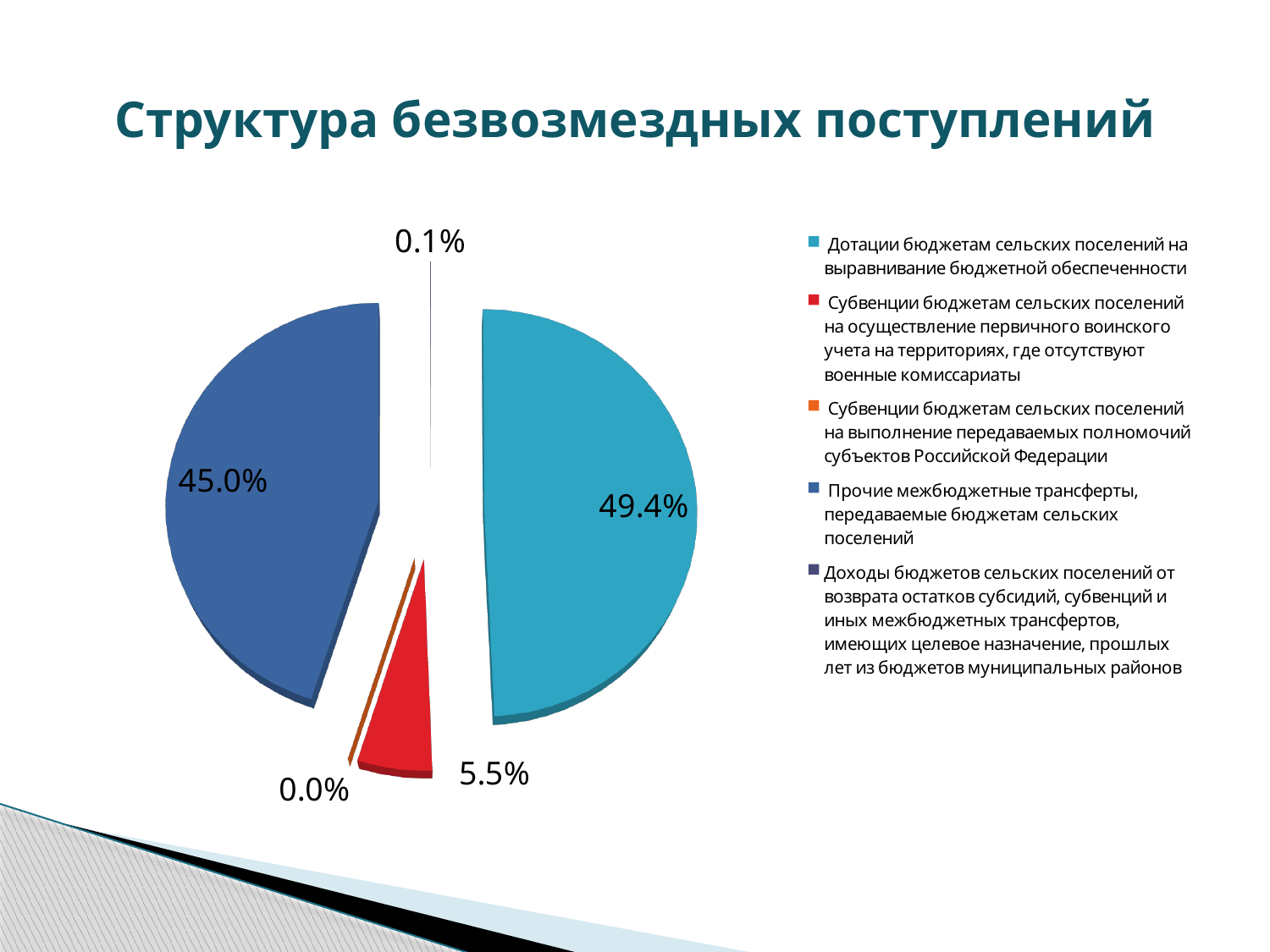
What is the title of the chart on the slide? Структура безвозмездных поступлений How many slices does the pie chart have? 5 What share of the pie is 'Дотации бюджетам сельских поселений на выравнивание бюджетной обеспеченности'? 49.4% What type of chart is shown on the slide? Pie chart What share of the pie is 'Доходы бюджетов сельских поселений от возврата остатков субсидий, субвенций и иных межбюджетных трансфертов, имеющих целевое назначение, прошлых лет из бюджетов муниципальных районов'? 0.1% How many entries does the legend list? 5 Which category has the largest share of the pie? Дотации бюджетам сельских поселений на выравнивание бюджетной обеспеченности Which is larger: the share for 'Прочие межбюджетные трансферты, передаваемые бюджетам сельских поселений' or the share for 'Субвенции бюджетам сельских поселений на осуществление первичного воинского учета на территориях, где отсутствуют военные комиссариаты'? Прочие межбюджетные трансферты, передаваемые бюджетам сельских поселений What share of the pie is 'Субвенции бюджетам сельских поселений на осуществление первичного воинского учета на территориях, где отсутствуют военные комиссариаты'? 5.5% What is the difference in percentage points between the 49.4% slice and the 45.0% slice? 4.4